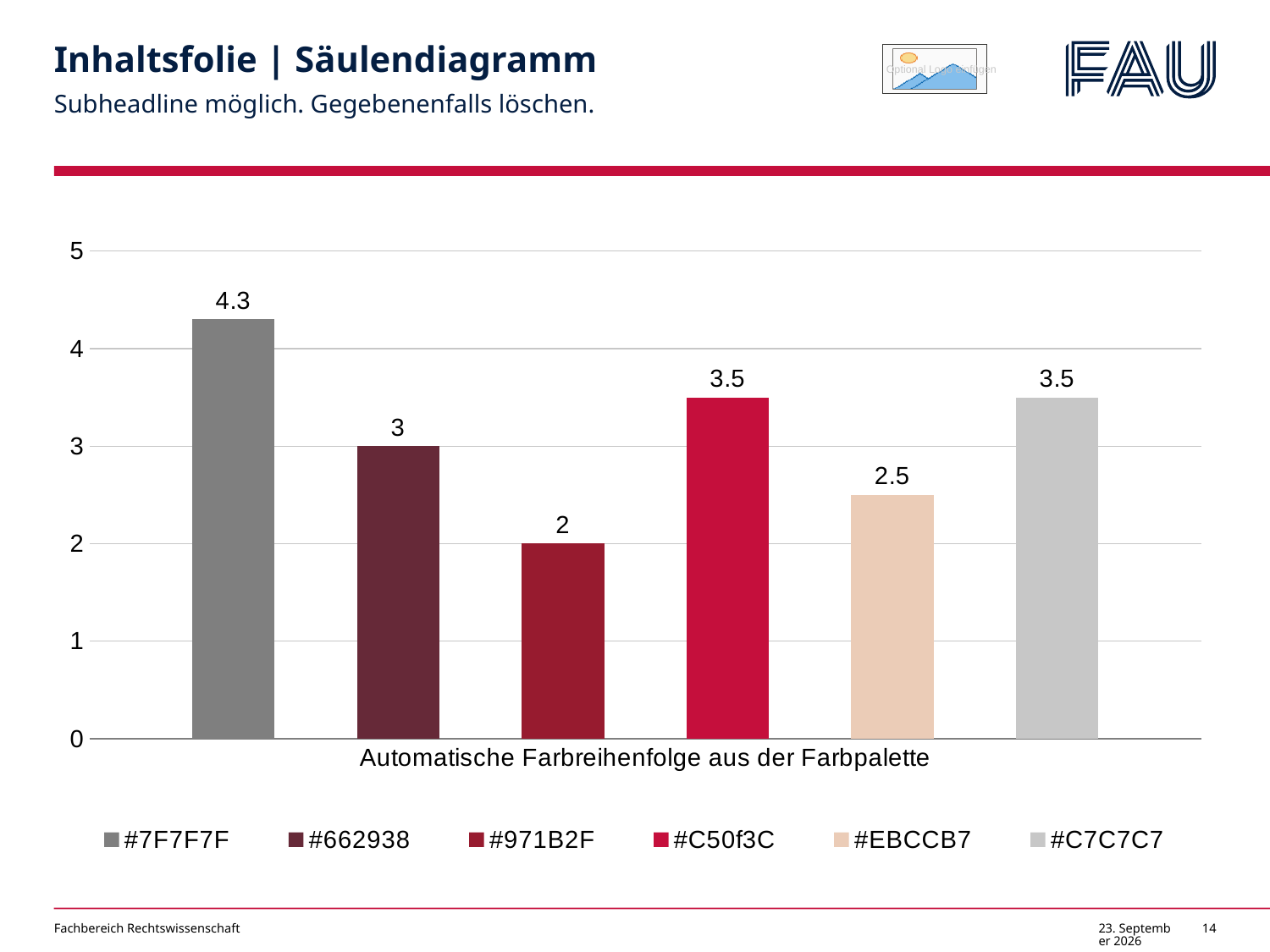
What type of chart is shown on the slide? bar chart Which series has the lowest value? #971B2F Which is larger, the value for #C50f3C or the value for #EBCCB7? #C50f3C What is the difference between the values of #7F7F7F and #971B2F? 2.3 What is the category label shown on the x axis? Automatische Farbreihenfolge aus der Farbpalette What is the difference between the values of #662938 and #EBCCB7? 0.5 What is the value of the #EBCCB7 series? 2.5 How many series does the legend list? 6 What is the value of the #7F7F7F series? 4.3 What is the value of the #662938 series? 3 What is the value of the #971B2F series? 2 Which series has the highest value? #7F7F7F